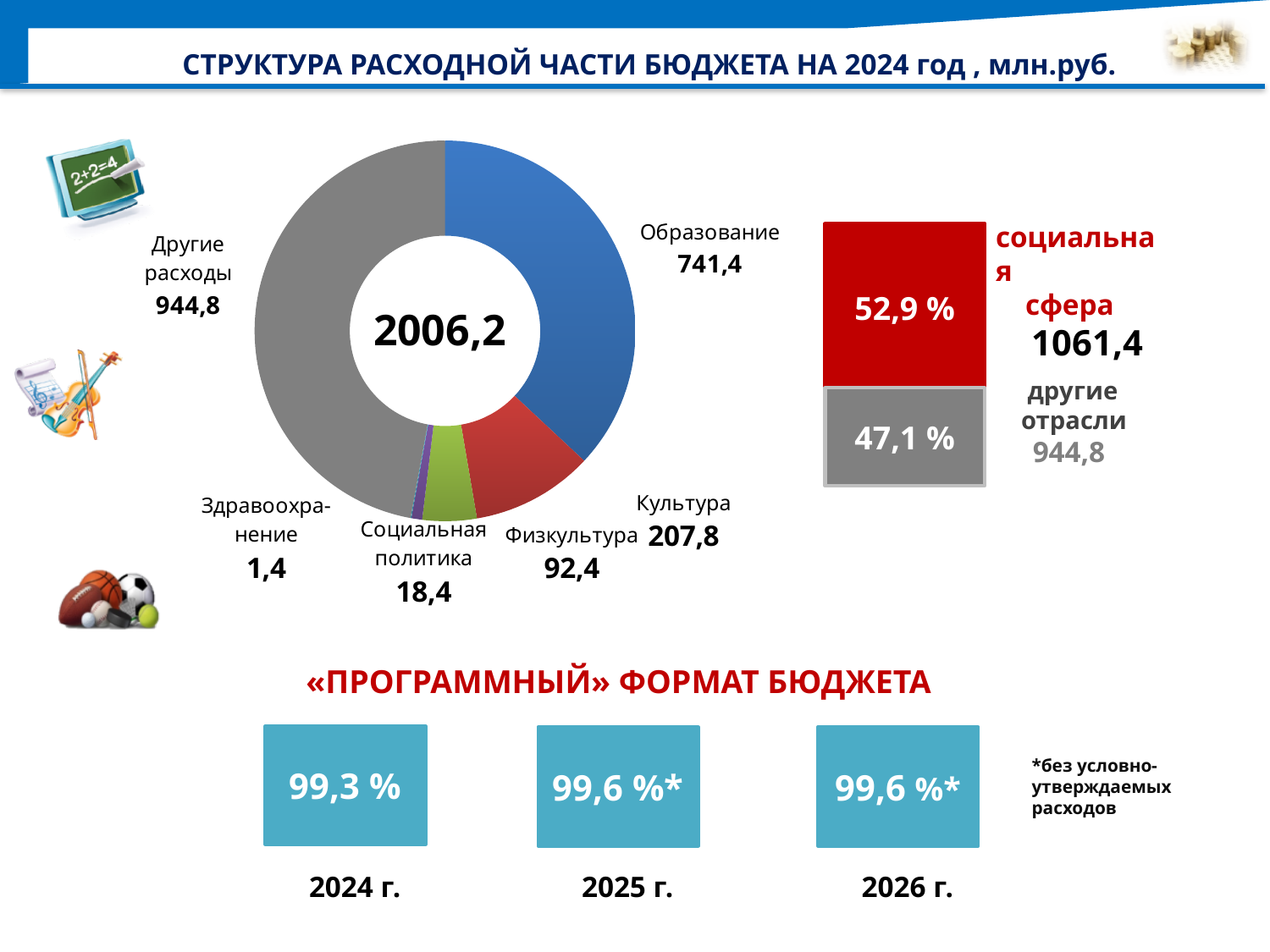
What kind of chart is used to show the structure of budget expenditures? Donut (pie) chart What is the value for Здравоохранение in the donut chart? 1,4 Which category in the donut chart has the largest value? Другие расходы Which is larger in the donut chart, Культура or Физкультура? Культура What is the difference between Другие расходы and Образование in the donut chart? 203,4 What is the value for Образование in the donut chart? 741,4 What is the value for Социальная политика in the donut chart? 18,4 What total value is shown in the centre of the donut chart? 2006,2 How many categories are shown in the donut chart? 6 What is the value for Физкультура in the donut chart? 92,4 Which category in the donut chart has the smallest value? Здравоохранение What is the value for Культура in the donut chart? 207,8